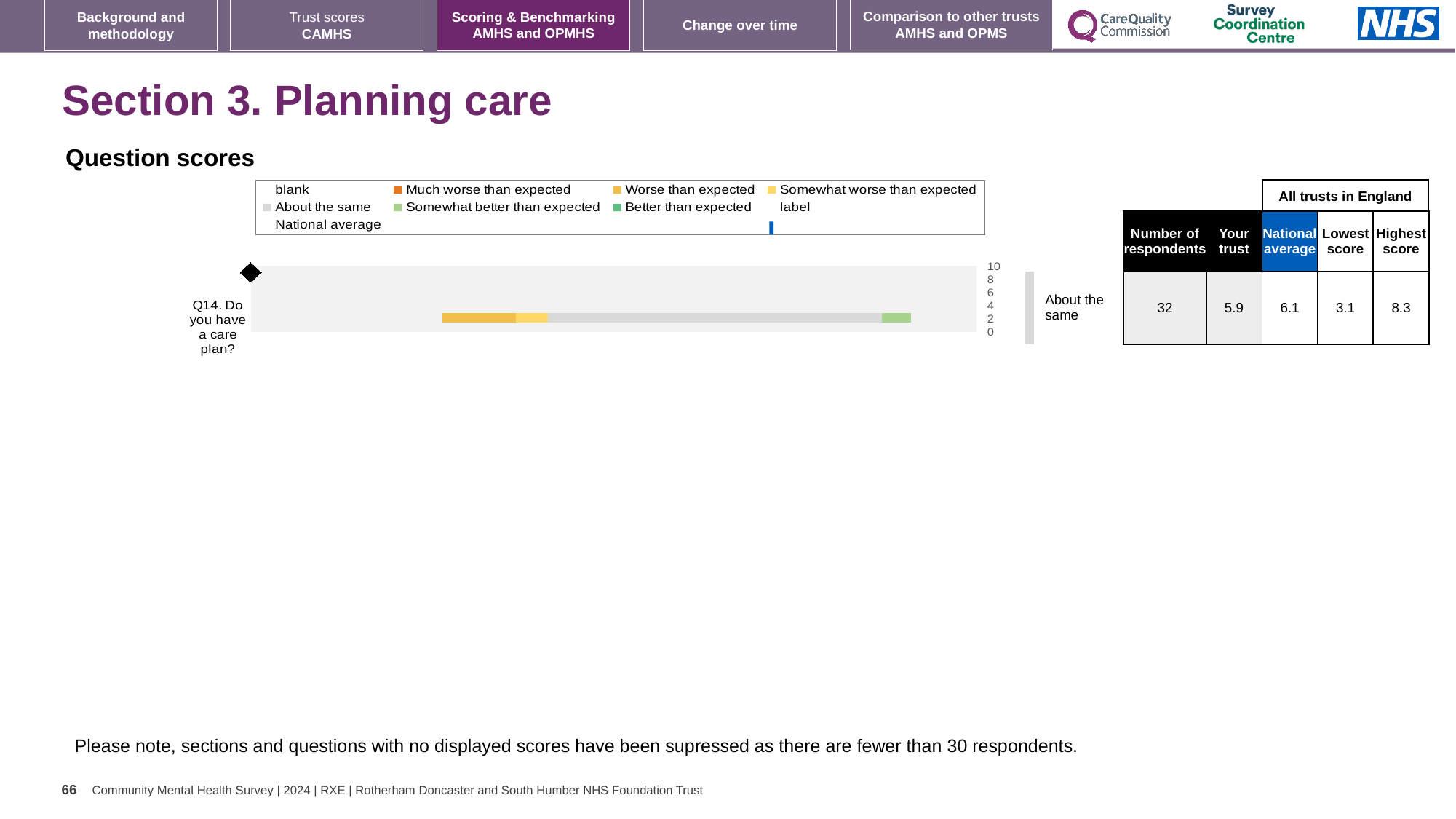
What kind of chart is used to show the Q14 question score? bar chart Which is larger for Q14, the 'Your trust' score or the national average? National average How many respondents answered Q14? 32 What is the difference between the national average and the 'Your trust' score for Q14? 0.2 Which question is shown in the Question scores chart? Q14. Do you have a care plan? What is the lowest score among all trusts in England for Q14? 3.1 How many questions are plotted in the Question scores chart? 1 What benchmark category is the trust's Q14 score placed in? About the same What is the highest score among all trusts in England for Q14? 8.3 What is the difference between the highest score and the lowest score for Q14? 5.2 What is the national average score for Q14? 6.1 What is the 'Your trust' score for Q14? 5.9